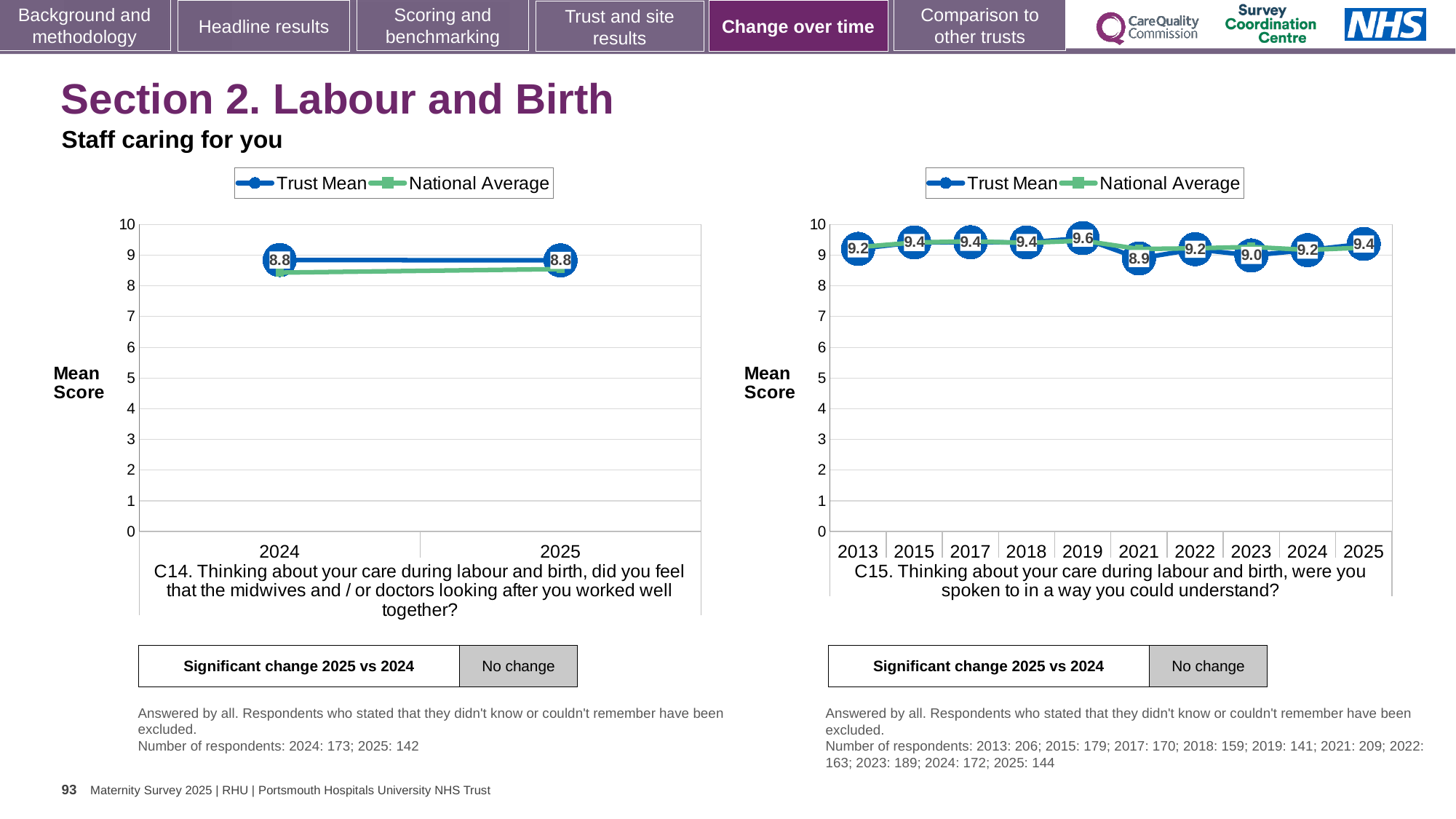
In the left chart (C14), what is the Trust Mean for 2025? 8.8 In the right chart (C15), how many years are plotted on the x axis? 10 In the right chart (C15), what is the difference between the Trust Mean in 2019 and in 2021? 0.7 In the right chart (C15), what is the Trust Mean for 2019? 9.6 In the right chart (C15), which year has the lowest Trust Mean? 2021 In the right chart (C15), what is the Trust Mean for 2021? 8.9 In the left chart (C14), what is the Trust Mean for 2024? 8.8 In the left chart (C14), how many years are shown on the x axis? 2 In the right chart (C15), is the Trust Mean higher in 2023 or in 2025? 2025 How many series does the legend of the right chart (C15) list? 2 In the right chart (C15), which year has the highest Trust Mean? 2019 In the left chart (C14), is the National Average for 2024 greater or less than 9? less